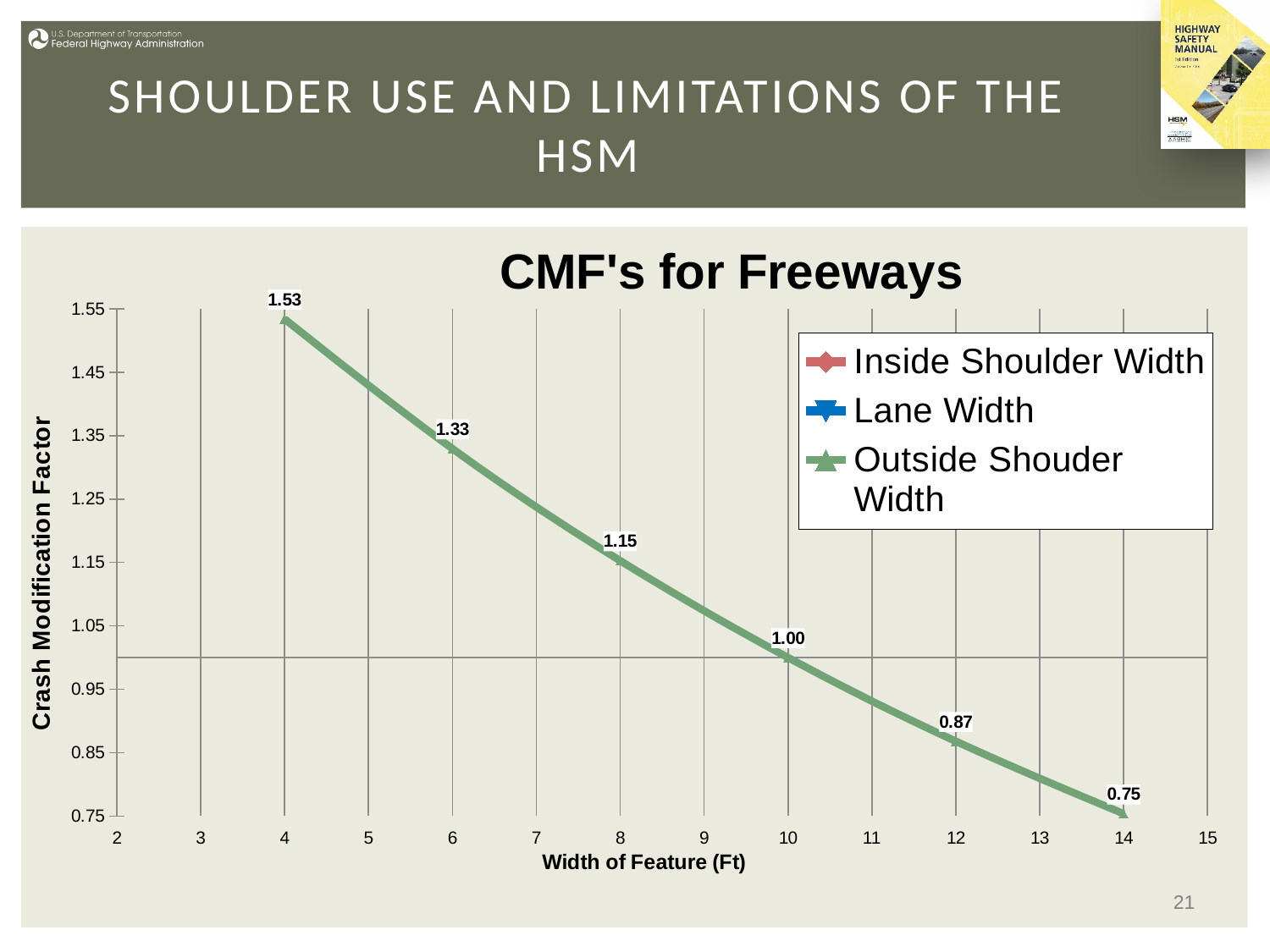
At which width of feature is the Outside Shoulder Width CMF lowest? 14 How many series does the legend list? 3 What is the Crash Modification Factor for Outside Shoulder Width at a width of 4 ft? 1.53 At which width of feature is the Outside Shoulder Width CMF highest? 4 What is the Crash Modification Factor for Outside Shoulder Width at a width of 10 ft? 1.00 Does the Outside Shoulder Width CMF rise or fall as the width of feature increases? fall Which is larger, the Outside Shoulder Width CMF at 8 ft or at 12 ft? 8 ft What is the difference between the Outside Shoulder Width CMF at 6 ft and at 8 ft? 0.18 How many labelled data points are plotted for Outside Shoulder Width? 6 What is the title of the chart? CMF's for Freeways What is the Crash Modification Factor for Outside Shoulder Width at a width of 14 ft? 0.75 What type of chart is shown on the slide? line chart